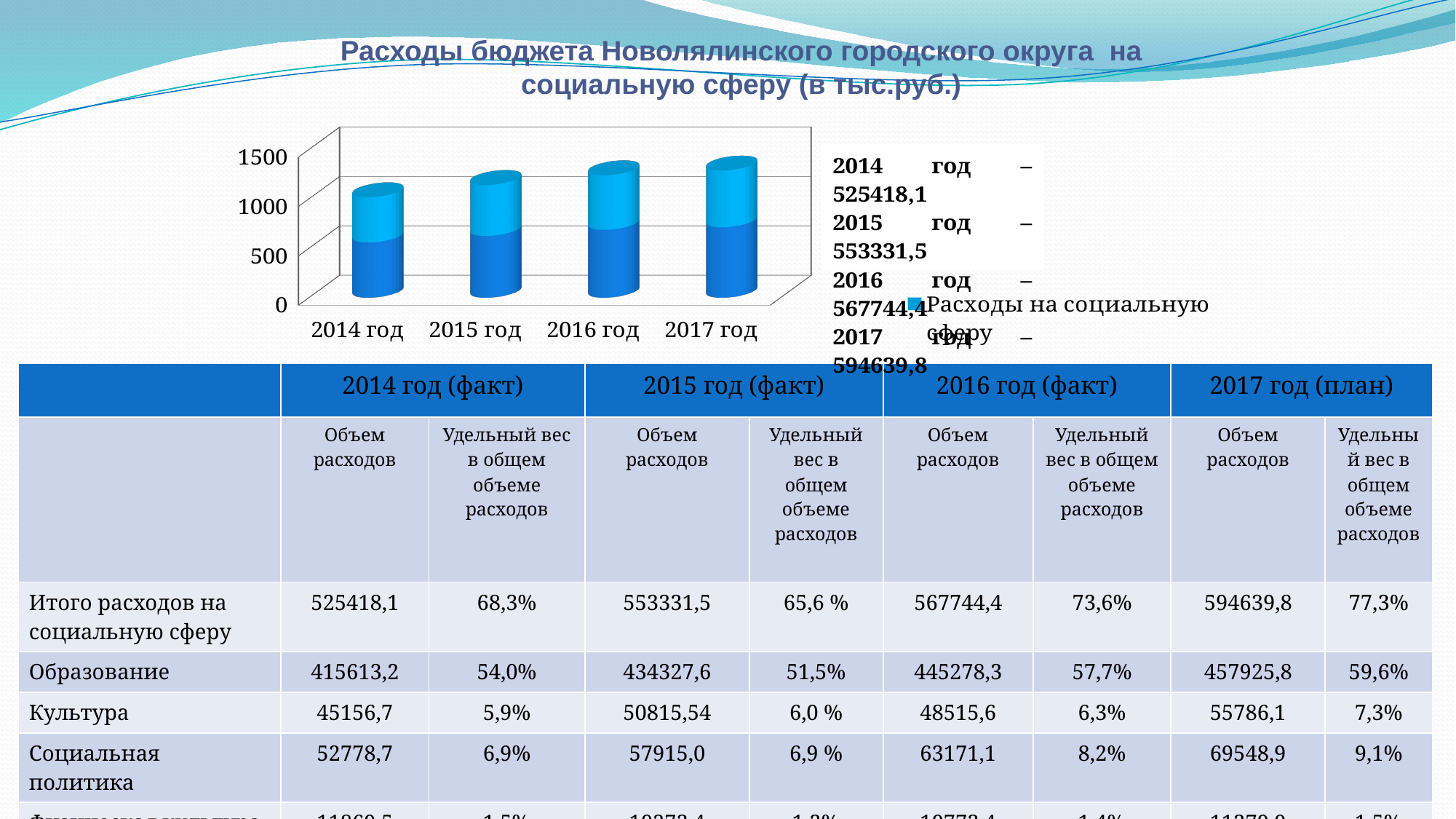
Is the bar for 2014 год greater or less than 1500 on the axis? less Which year has the shortest bar in the chart? 2014 год Which year has the tallest bar in the chart? 2017 год How many categories (years) are shown on the x axis of the chart? 4 Do the bar values rise or fall from 2014 год to 2017 год? rise What is the name of the series in the chart legend? Расходы на социальную сферу Which bar is taller, 2014 год or 2017 год? 2017 год What is the title of the slide containing the chart? Расходы бюджета Новолялинского городского округа на социальную сферу (в тыс.руб.) Is the bar for 2017 год greater or less than 1000 on the axis? greater What kind of chart is shown on the slide? bar chart Which bar is taller, 2015 год or 2017 год? 2017 год